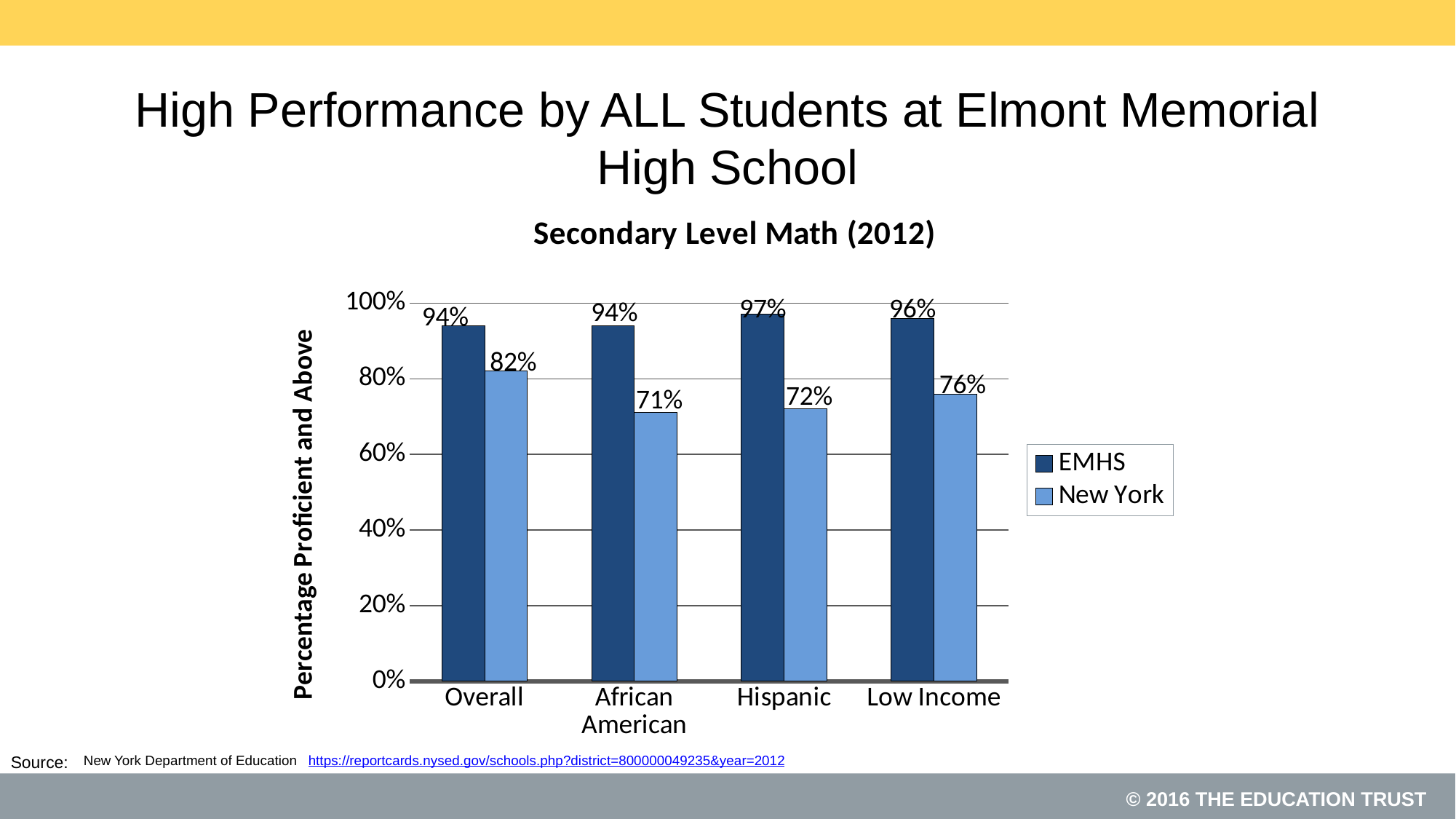
Which is larger for Hispanic students, the EMHS value or the New York value? EMHS How many series does the legend list? 2 What is the EMHS value for Hispanic students? 97% What is the New York value for the Overall category? 82% What kind of chart is shown on the slide? Bar chart What is the New York value for African American students? 71% Which category has the highest EMHS value? Hispanic What is the difference between the EMHS and New York values for Low Income students? 20% Which category has the lowest New York value? African American What is the EMHS value for Low Income students? 96% What is the title of the chart? Secondary Level Math (2012) How many categories are shown on the x axis? 4